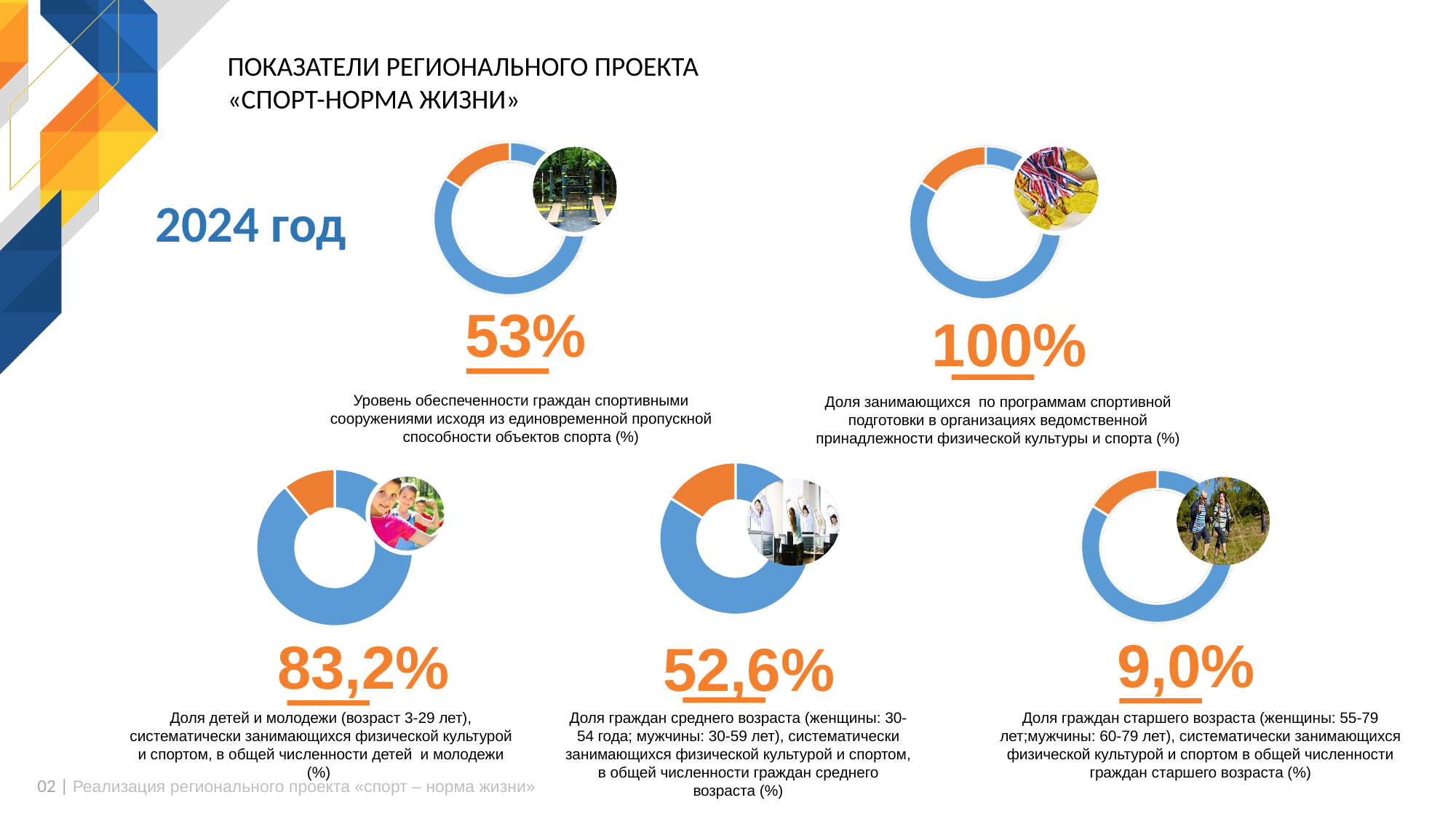
What value is shown for the chart 'Доля граждан среднего возраста, систематически занимающихся физической культурой и спортом'? 52,6% What type of chart is used to display the indicators on the slide? Donut chart What value is shown for the chart 'Уровень обеспеченности граждан спортивными сооружениями исходя из единовременной пропускной способности объектов спорта (%)'? 53% Which is larger: the share for children and youth (3-29 лет) or the share for middle-aged citizens? Children and youth (83,2%) How many donut charts are shown on the slide? 5 What value is shown for the chart 'Доля занимающихся по программам спортивной подготовки в организациях ведомственной принадлежности физической культуры и спорта (%)'? 100% What value is shown for the chart 'Доля детей и молодежи (возраст 3-29 лет), систематически занимающихся физической культурой и спортом'? 83,2% What is the difference in percentage points between the share for children and youth (83,2%) and the share for middle-aged citizens (52,6%)? 30,6 Which of the five indicators on the slide has the highest value? Доля занимающихся по программам спортивной подготовки (100%) What value is shown for the chart 'Доля граждан старшего возраста, систематически занимающихся физической культурой и спортом'? 9,0% Which of the five indicators on the slide has the lowest value? Доля граждан старшего возраста (9,0%) What is the difference in percentage points between the sports training programs indicator (100%) and the sports facilities provision indicator (53%)? 47